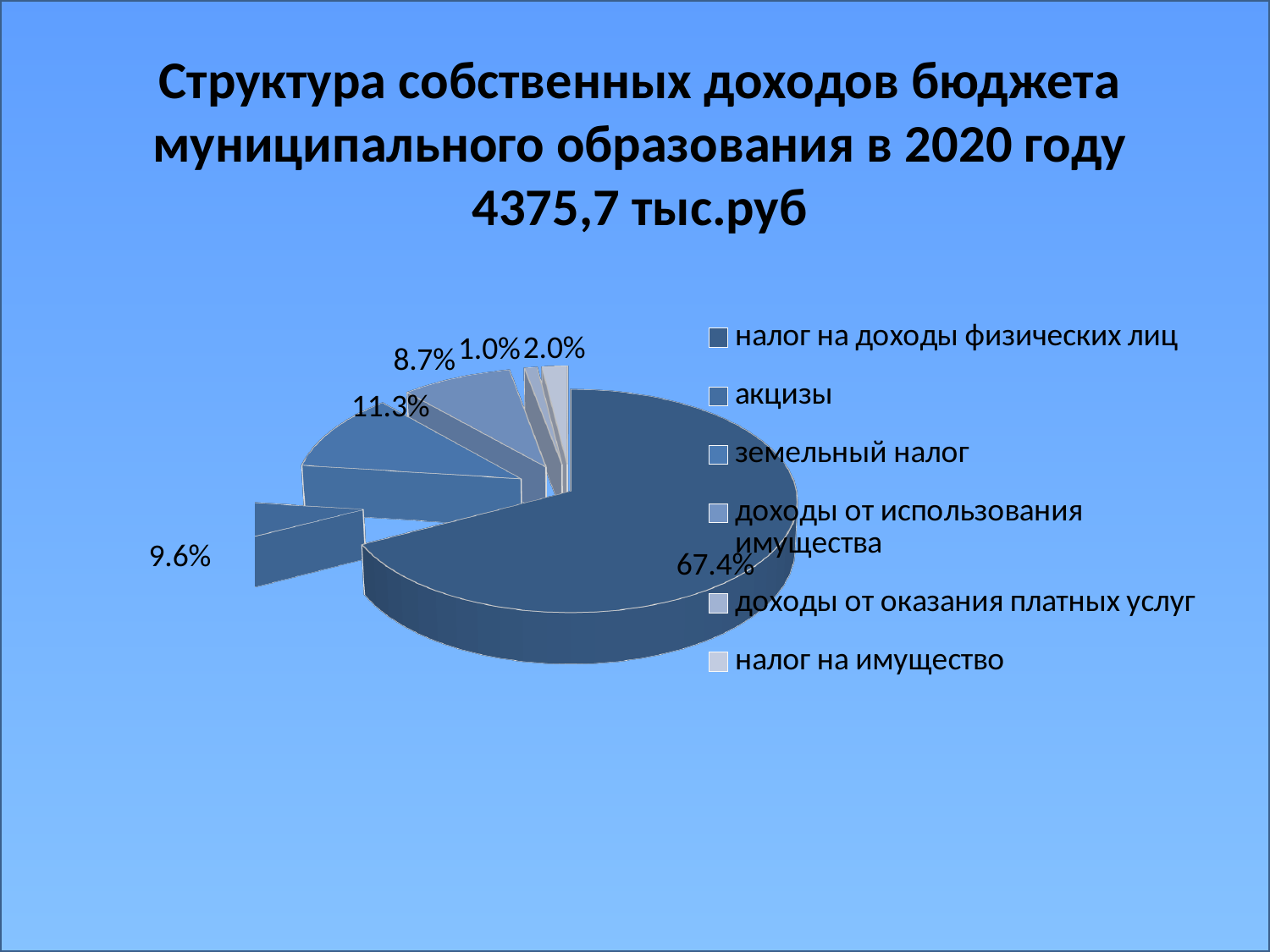
By how many percentage points does the share of налог на доходы физических лиц exceed the share of доходы от использования имущества? 58.7 What percentage is shown for доходы от использования имущества? 8.7% Which category has the largest slice of the pie? налог на доходы физических лиц Which category has the smallest slice of the pie? доходы от оказания платных услуг How many slices does the pie chart have? 6 What percentage is shown for налог на имущество? 2.0% What percentage is shown for акцизы? 9.6% What total amount in тыс.руб is stated in the chart title? 4375,7 тыс.руб What share of the pie is labelled for налог на доходы физических лиц? 67.4% What percentage is shown for земельный налог? 11.3% Which is larger: the share of налог на имущество or the share of доходы от оказания платных услуг? налог на имущество What kind of chart is shown on the slide? pie chart